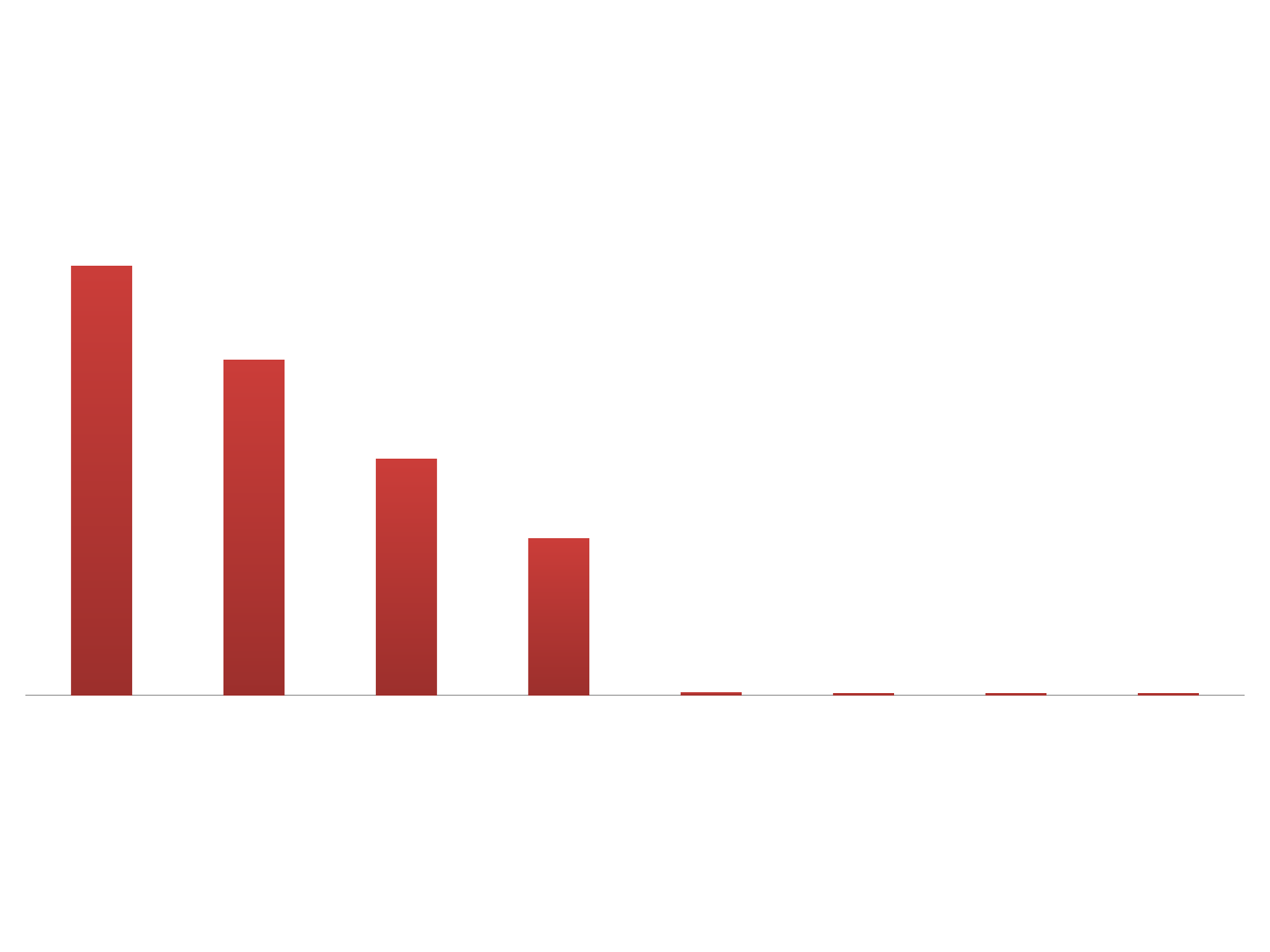
How many bars in the chart are clearly tall, compared with the near-zero bars on the right? 4 What kind of chart is shown on the slide? bar chart Which is larger, the third bar from the left or the fourth bar from the left? the third bar Which is larger, the fourth bar from the left or the fifth bar from the left? the fourth bar Which bar is the tallest in the chart? the leftmost (first) bar Which is larger, the first bar from the left or the second bar from the left? the first bar How many bars does the chart contain? 8 Do the bar values rise or fall from left to right across the chart? fall What colour are the bars in the chart? red